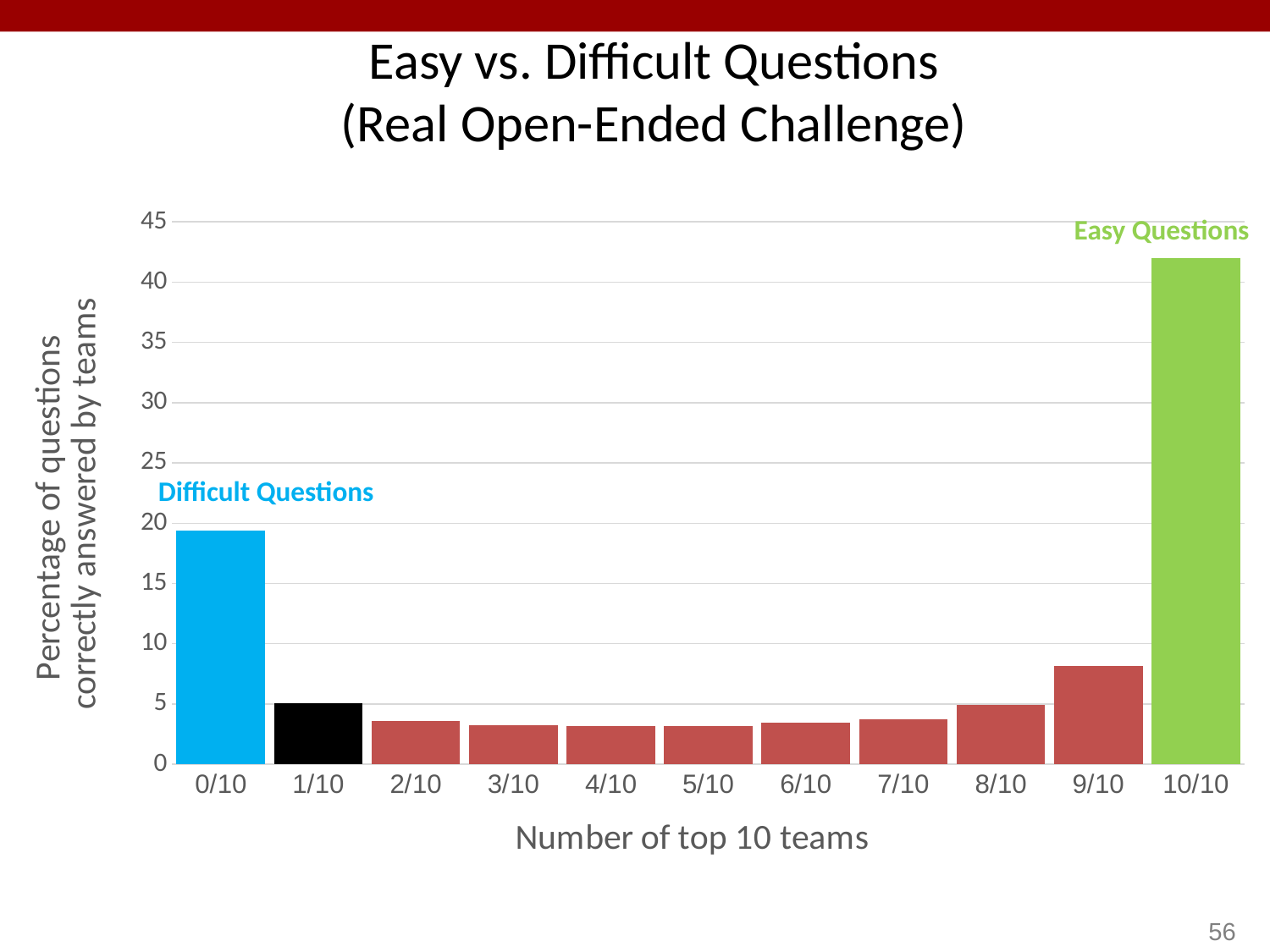
Is the value for 4/10 greater or less than 5? less Which is larger, the value for 0/10 or the value for 9/10? 0/10 Is the value for 0/10 greater or less than 15? greater Which category has the highest percentage of questions correctly answered? 10/10 Which is larger, the value for 9/10 or the value for 8/10? 9/10 Is the value for 9/10 greater or less than 10? less Which bar is annotated as 'Easy Questions'? 10/10 How many categories are shown on the x axis of the chart? 11 What is the label of the x axis? Number of top 10 teams What kind of chart is shown on the slide? bar chart